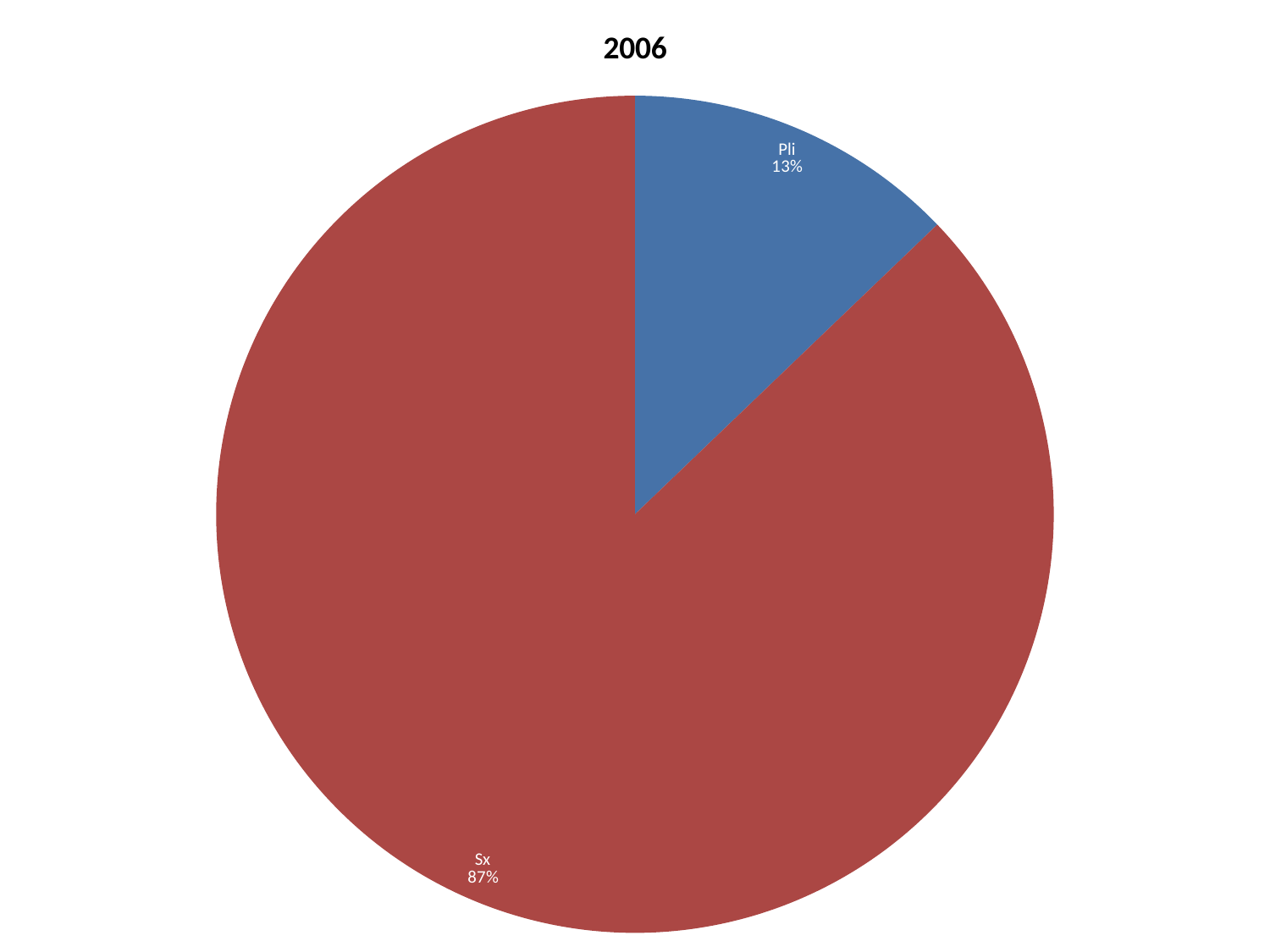
What is the difference in percentage points between the Sx and Pli slices? 74 What share of the pie does Sx represent? 87% How many slices does the pie chart have? 2 What is the title of the chart? 2006 What kind of chart is shown on the slide? pie chart Which slice is the smallest? Pli Which is larger, the Sx slice or the Pli slice? Sx What share of the pie does Pli represent? 13% What colour is the Pli slice? blue Which slice is the largest? Sx